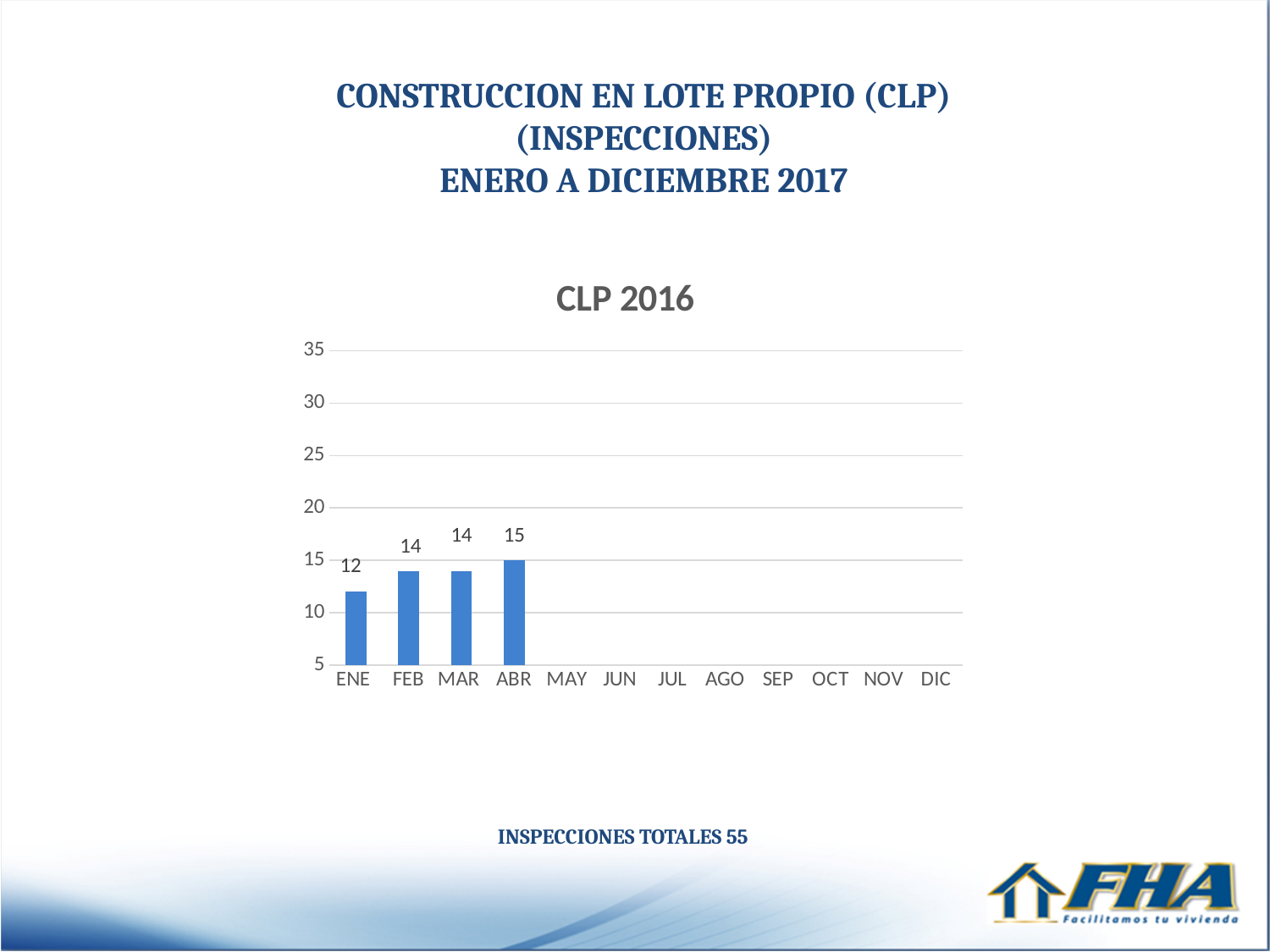
Which is larger in the CLP 2016 chart, the value for ENE or the value for ABR? ABR What is the title of the chart on the slide? CLP 2016 Is the value for ENE in the CLP 2016 chart greater or less than 15? less Among the months that have a bar in the CLP 2016 chart, which has the lowest value? ENE Do the values rise or fall from ENE to ABR in the CLP 2016 chart? rise How many month categories are shown on the x axis of the CLP 2016 chart? 12 What is the value for FEB in the CLP 2016 chart? 14 What is the difference between the values for ABR and ENE in the CLP 2016 chart? 3 What is the value for ABR in the CLP 2016 chart? 15 Which month has the highest bar in the CLP 2016 chart? ABR What kind of chart is the CLP 2016 chart? bar chart What is the value for ENE in the CLP 2016 chart? 12